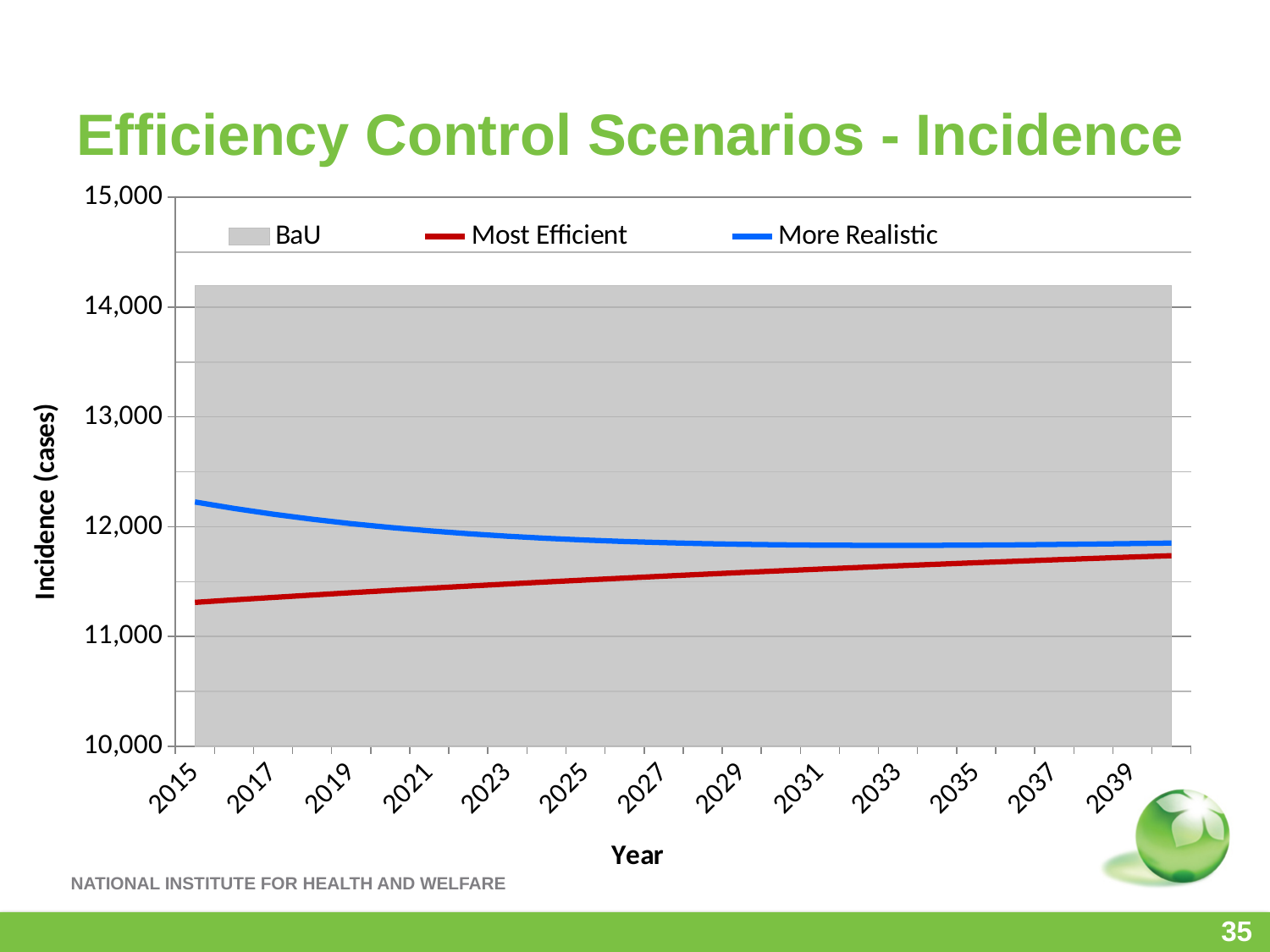
Is the value for More Realistic in 2015 greater or less than 12,000? greater How many series does the chart legend list? 3 Does the Most Efficient series rise or fall from 2015 to 2039? rise Is the value for Most Efficient in 2015 greater or less than 12,000? less What is the title of the chart? Efficiency Control Scenarios - Incidence What kind of chart is shown on the slide? combination area and line chart Which series has the highest incidence values across the chart? BaU Is the value for BaU greater or less than 14,000? greater Does the More Realistic series rise or fall from 2015 to 2039? fall In 2015, which is larger: Most Efficient or More Realistic? More Realistic What is the label of the vertical axis? Incidence (cases)